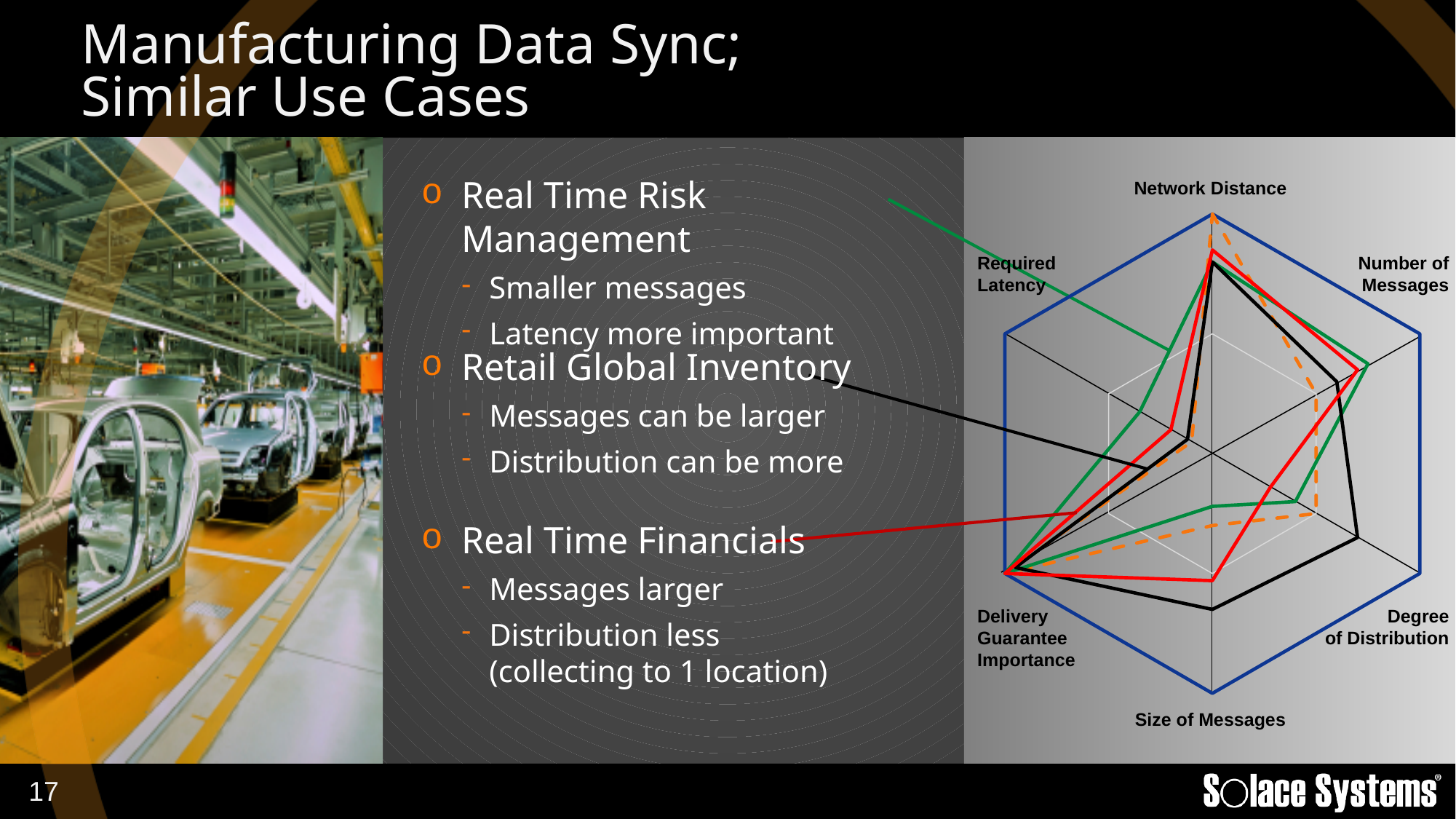
How many axes (categories) does the radar chart have? 6 What kind of chart is shown on the right side of the slide? Radar chart Which use case does the green line on the radar chart represent, according to the connector line? Real Time Risk Management Which category label appears at the top of the radar chart? Network Distance On the Degree of Distribution axis, which line reaches furthest from the centre: the black line or the green line? The black line On the Network Distance axis, which line reaches furthest from the centre: the orange dashed line or the black line? The orange dashed line On the Size of Messages axis, which line reaches furthest from the centre: the black line or the red line? The black line